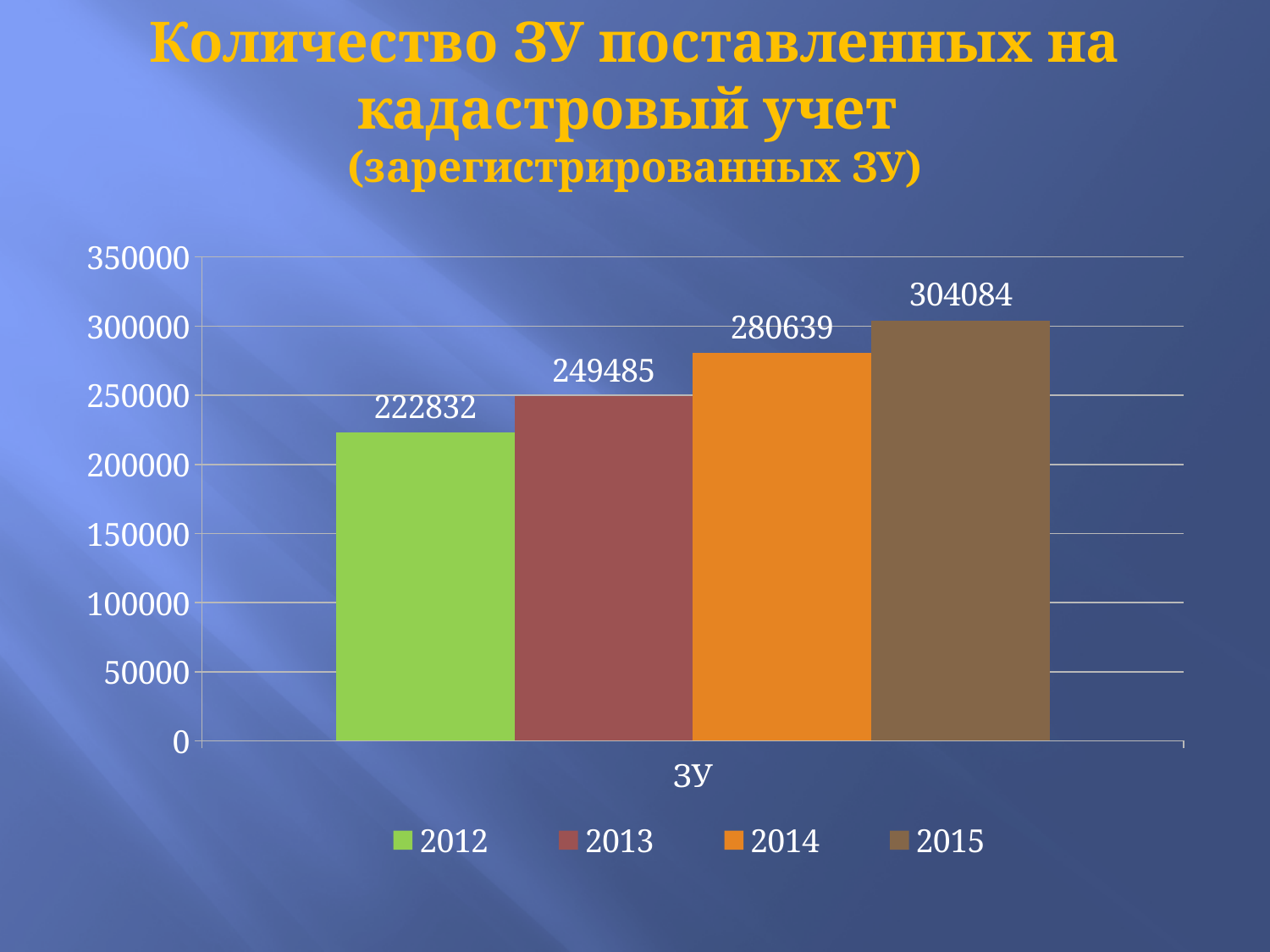
Which year has the lowest value? 2012 What is the value for 2012? 222832 Which is larger, the value for 2013 or the value for 2014? 2014 What is the difference between the values for 2015 and 2012? 81252 What kind of chart is shown on the slide? bar chart Is the value for 2013 greater or less than 250000? less How many series does the legend list? 4 Do the values rise or fall from 2012 to 2015? rise What is the difference between the values for 2014 and 2013? 31154 What is the value for 2014? 280639 Which year has the highest value? 2015 What is the value for 2015? 304084